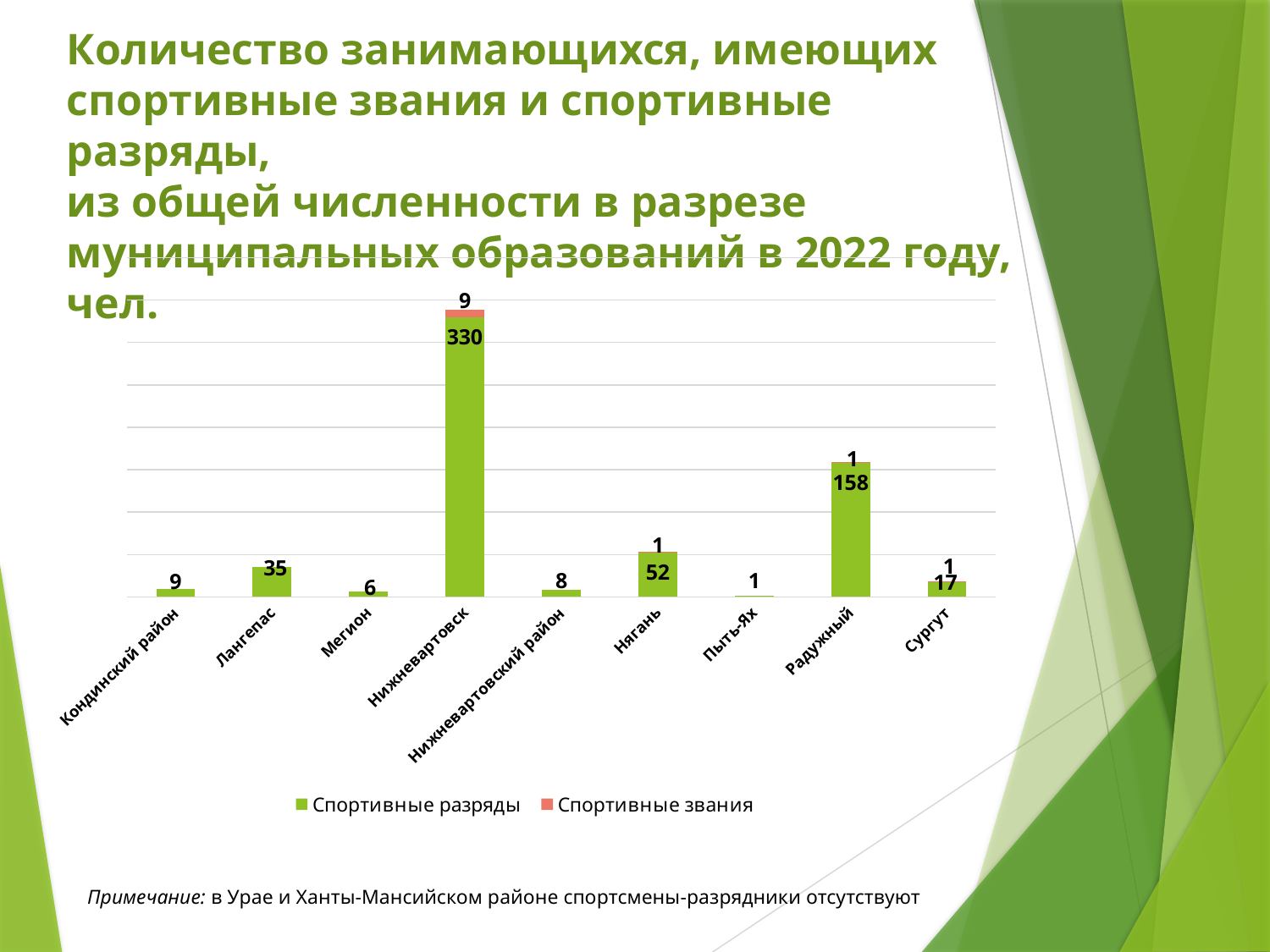
Which municipality has the lowest value of Спортивные разряды? Пыть-Ях How many municipalities are shown on the x axis of the chart? 9 What is the total of the stacked bar for Нягань? 53 What type of chart is shown on the slide? bar chart Which municipality has the highest value of Спортивные разряды? Нижневартовск How many series does the legend list? 2 What is the value of Спортивные звания for Нижневартовск? 9 What is the difference between the Спортивные разряды values for Нижневартовск and Радужный? 172 What is the value of Спортивные разряды for Радужный? 158 What is the value of Спортивные разряды for Нижневартовск? 330 Which has a larger Спортивные разряды value, Сургут or Мегион? Сургут What is the value of Спортивные разряды for Лангепас? 35